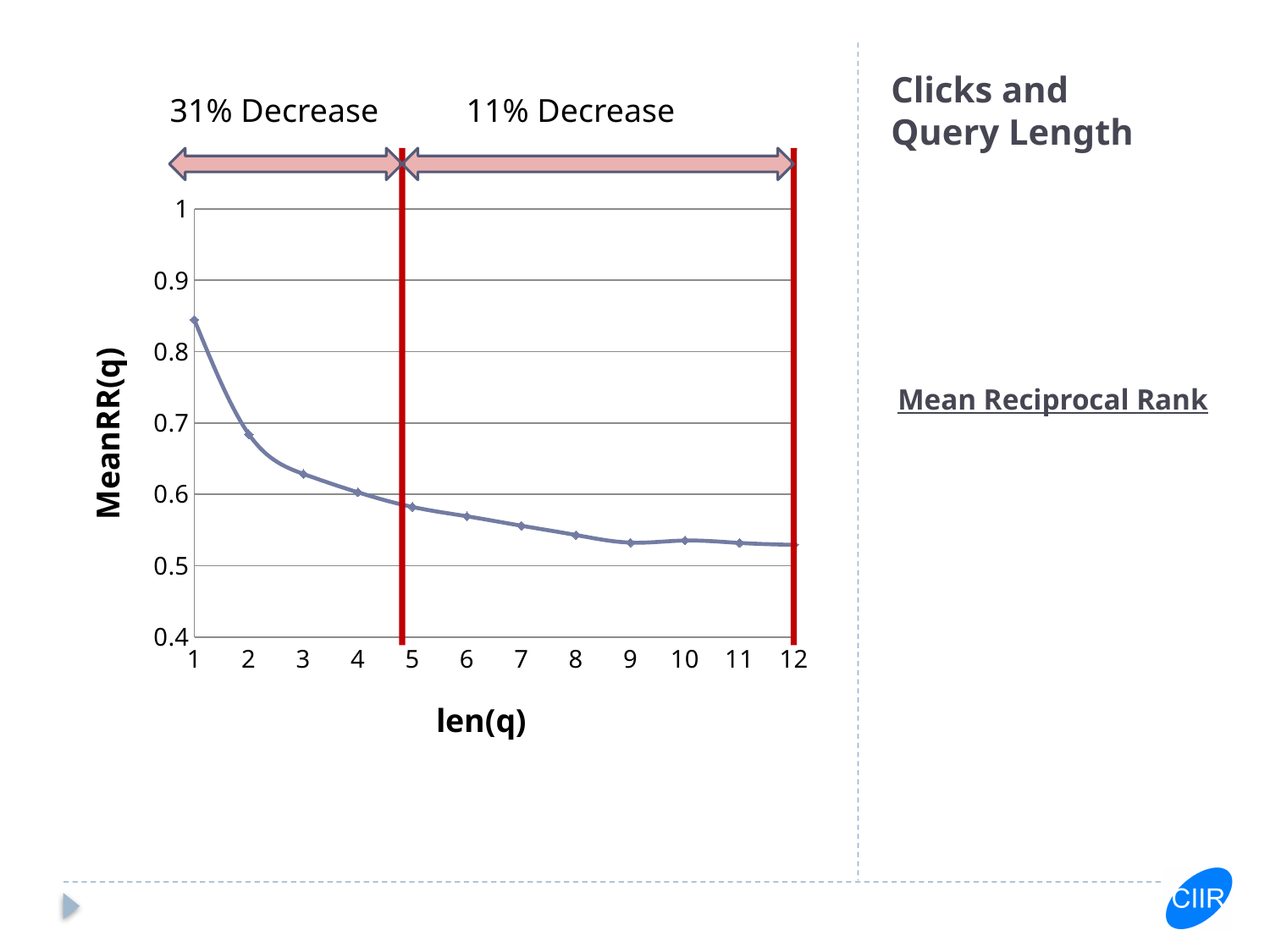
What percentage decrease is annotated above the chart for the range from len(q) = 5 to 12? 11% Decrease How many data points are plotted along the x axis? 12 Which has a larger MeanRR(q): len(q) = 2 or len(q) = 8? len(q) = 2 At which value of len(q) is MeanRR(q) highest? 1 What is the label on the x axis? len(q) What kind of chart is shown on the slide? line chart Is the value for len(q) = 5 greater or less than 0.6? less Is the value for len(q) = 1 greater or less than 0.9? less Is the value for len(q) = 9 greater or less than 0.5? greater Do the MeanRR(q) values rise or fall as len(q) increases? fall